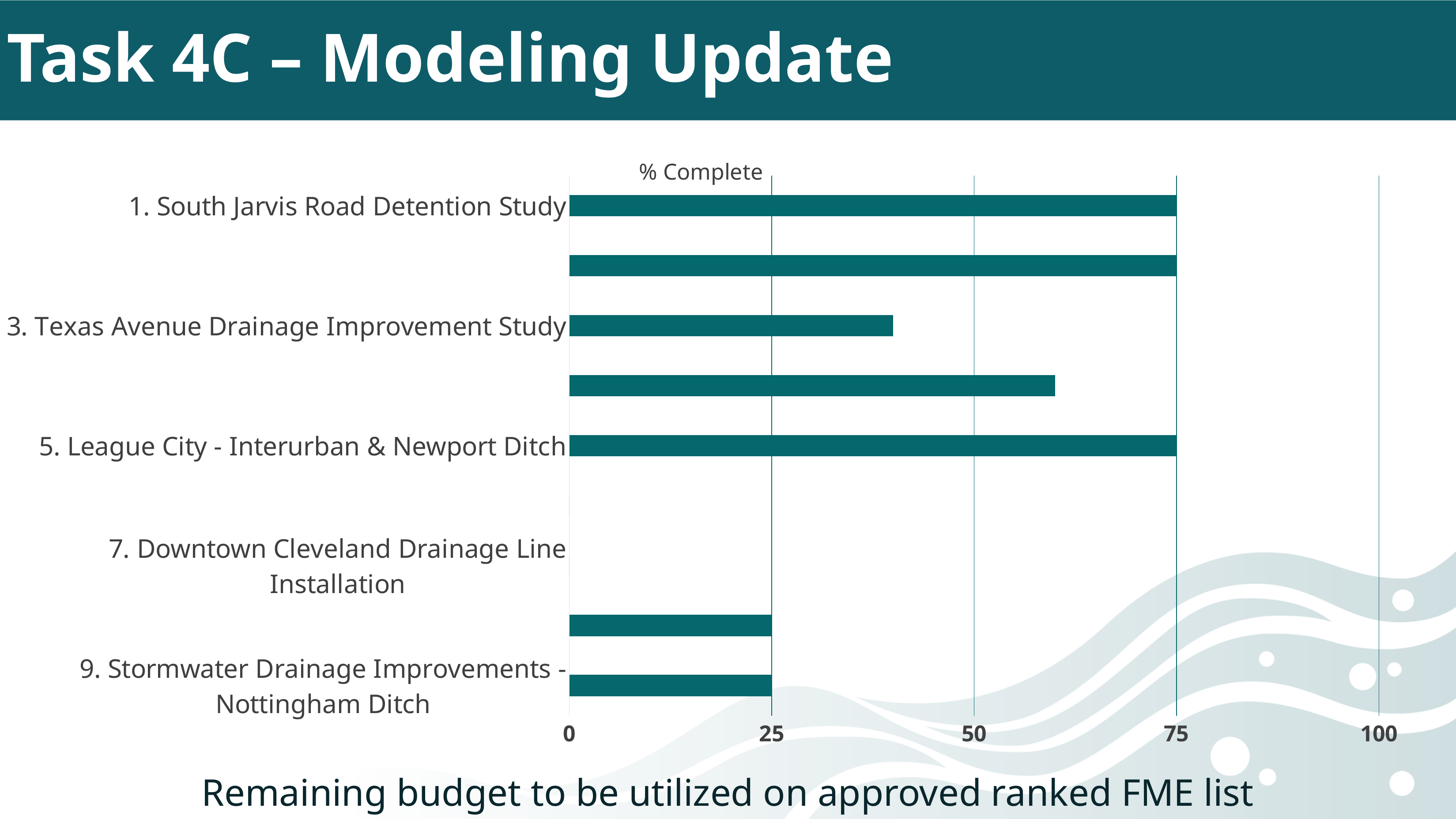
What is the % Complete value for 5. League City - Interurban & Newport Ditch? 75 What is the % Complete value for 9. Stormwater Drainage Improvements - Nottingham Ditch? 25 What type of chart is shown on the slide? bar chart Is the value for 3. Texas Avenue Drainage Improvement Study greater or less than 25? greater What is the difference in % Complete between 1. South Jarvis Road Detention Study and 9. Stormwater Drainage Improvements - Nottingham Ditch? 50 What is the % Complete value for 1. South Jarvis Road Detention Study? 75 What is the title of the chart? % Complete Which has a higher % Complete: 1. South Jarvis Road Detention Study or 3. Texas Avenue Drainage Improvement Study? 1. South Jarvis Road Detention Study What is the maximum value shown on the horizontal axis? 100 Is the value for 3. Texas Avenue Drainage Improvement Study greater or less than 50? less Which has a higher % Complete: 5. League City - Interurban & Newport Ditch or 9. Stormwater Drainage Improvements - Nottingham Ditch? 5. League City - Interurban & Newport Ditch